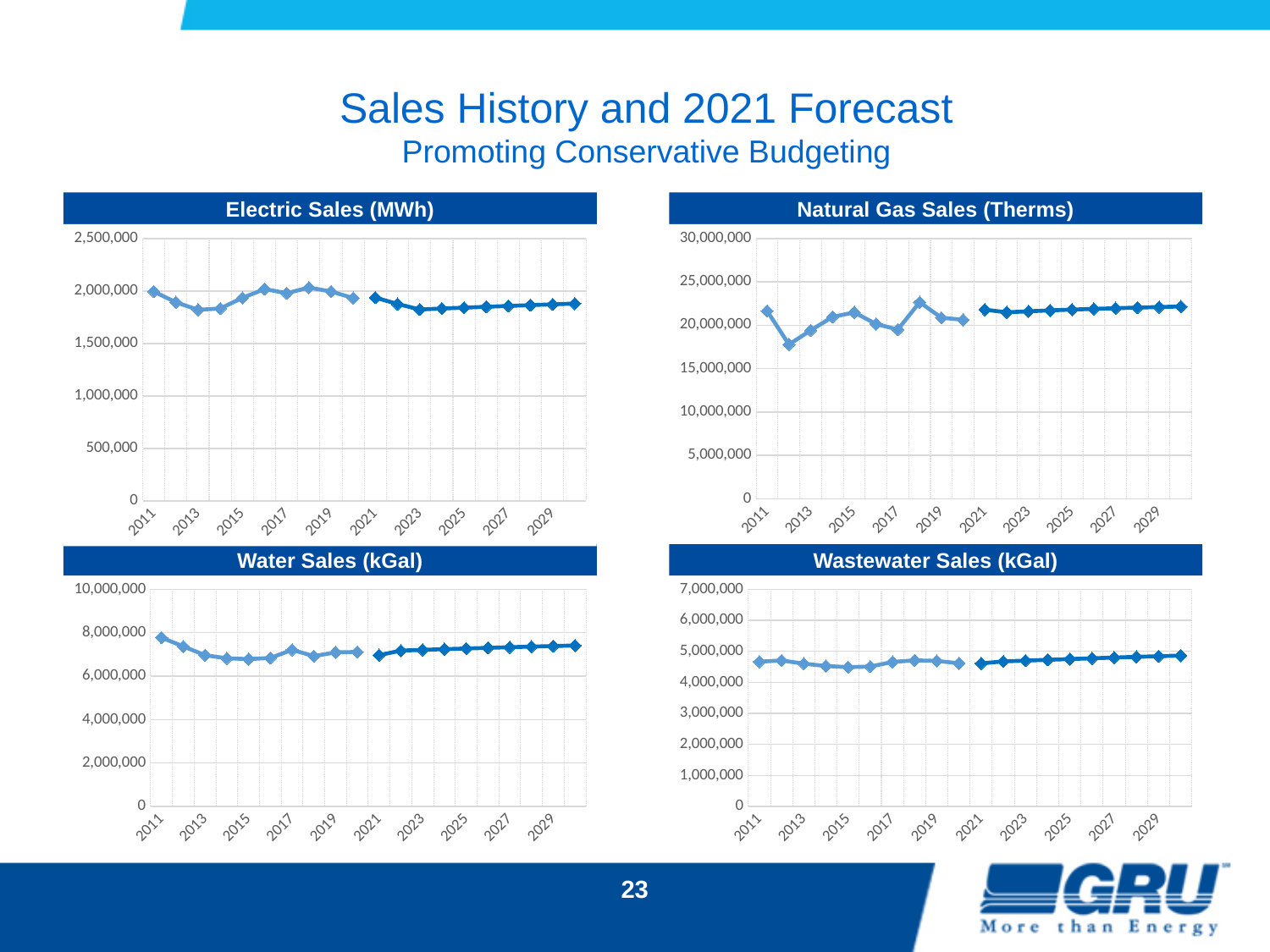
In the Electric Sales (MWh) chart, is the value for 2011 greater or less than 1,500,000? greater In the Natural Gas Sales (Therms) chart, which year has the lowest value? 2012 What is the title of the chart in the top right of the slide? Natural Gas Sales (Therms) In the Wastewater Sales (kGal) chart, do the values rise or fall from 2021 to 2030? rise How many charts are shown on the slide? 4 In the Water Sales (kGal) chart, which year has the highest value? 2011 In the Electric Sales (MWh) chart, do the values rise or fall from 2011 to 2014? fall In the Natural Gas Sales (Therms) chart, is the value for 2012 greater or less than 20,000,000? less What kind of chart is the Electric Sales (MWh) chart? line chart In the Wastewater Sales (kGal) chart, is the value for 2011 greater or less than 5,000,000? less